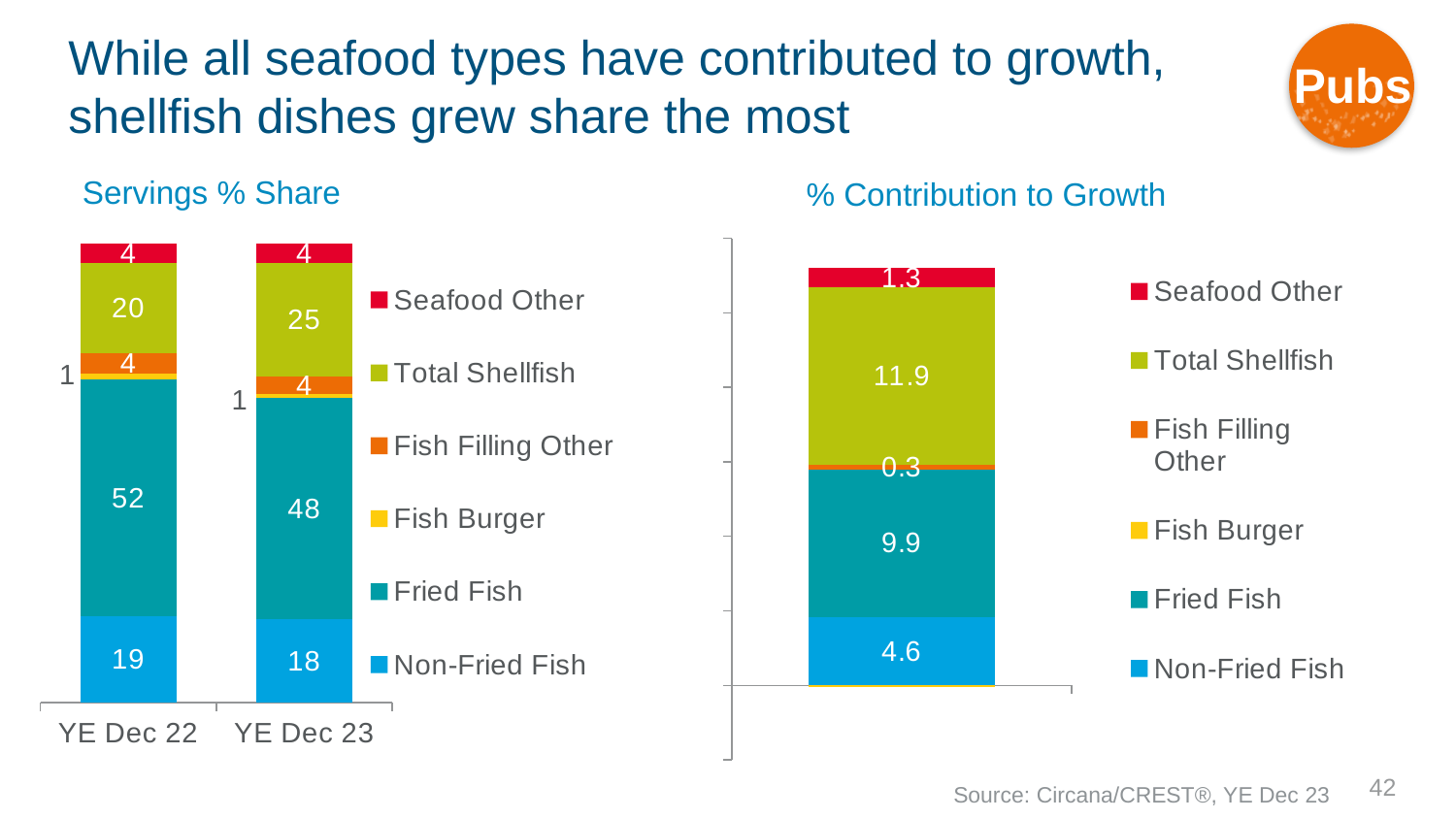
In the Servings % Share chart, how many bars (time periods) are shown? 2 In the Servings % Share chart, what is the difference between the Fried Fish values for YE Dec 22 and YE Dec 23? 4 In the Servings % Share chart, what is the value for Total Shellfish in YE Dec 23? 25 In the % Contribution to Growth chart, what is the value for Total Shellfish? 11.9 In the % Contribution to Growth chart, which series contributed the most to growth? Total Shellfish In the % Contribution to Growth chart, which is larger: Non-Fried Fish or Seafood Other? Non-Fried Fish In the Servings % Share chart, by how much did the Total Shellfish share change from YE Dec 22 to YE Dec 23? 5 In the Servings % Share chart, which series has the largest share in YE Dec 23? Fried Fish In the Servings % Share chart, what is the value for Fried Fish in YE Dec 22? 52 In the Servings % Share chart, how many series does the legend list? 6 In the % Contribution to Growth chart, what is the value for Fried Fish? 9.9 What kind of chart is the Servings % Share chart? Stacked bar chart